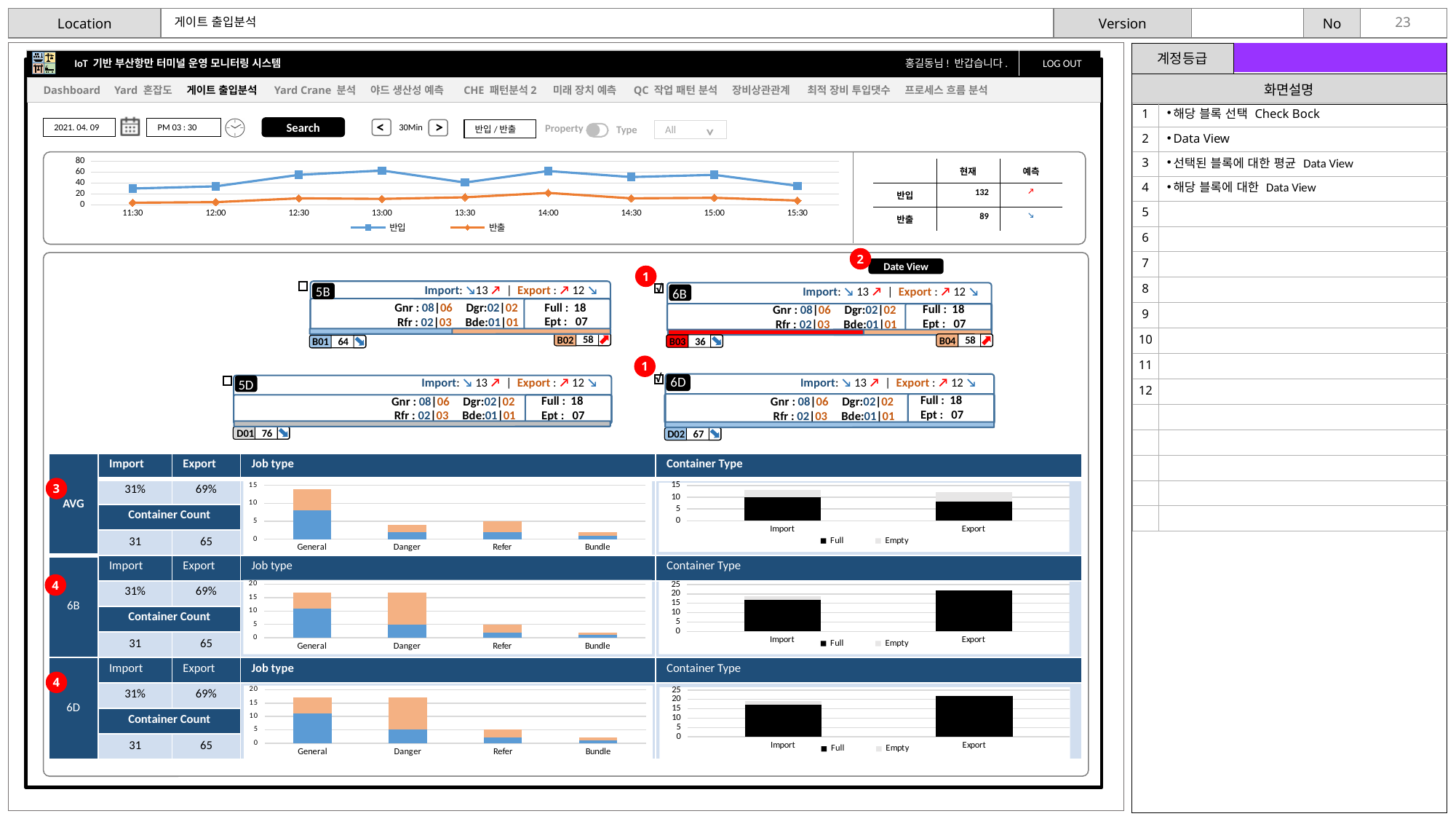
In the 6B row's Container Type chart, which is larger, Import or Export? Export What kind of chart is the Job type chart in the 6B row? bar chart In the AVG row's Job type chart, which category has the lowest bar? Bundle In the AVG row's Job type chart, which category has the highest bar? General What kind of chart is the chart at the top of the slide with the 11:30 to 15:30 x axis? line chart In the line chart at the top of the slide, which series has the larger value at 14:00, 반입 or 반출? 반입 In the line chart at the top of the slide, how many series does the legend list? 2 In the 6B row's Job type chart, is the value for Refer greater or less than 10? less In the line chart at the top of the slide, how many time points are shown on the x axis? 9 In the 6D row's Container Type chart, what are the two legend entries? Full, Empty In the line chart at the top of the slide, is the value for 반입 at 13:00 greater or less than 40? greater In the AVG row's Job type chart, how many categories are shown on the x axis? 4